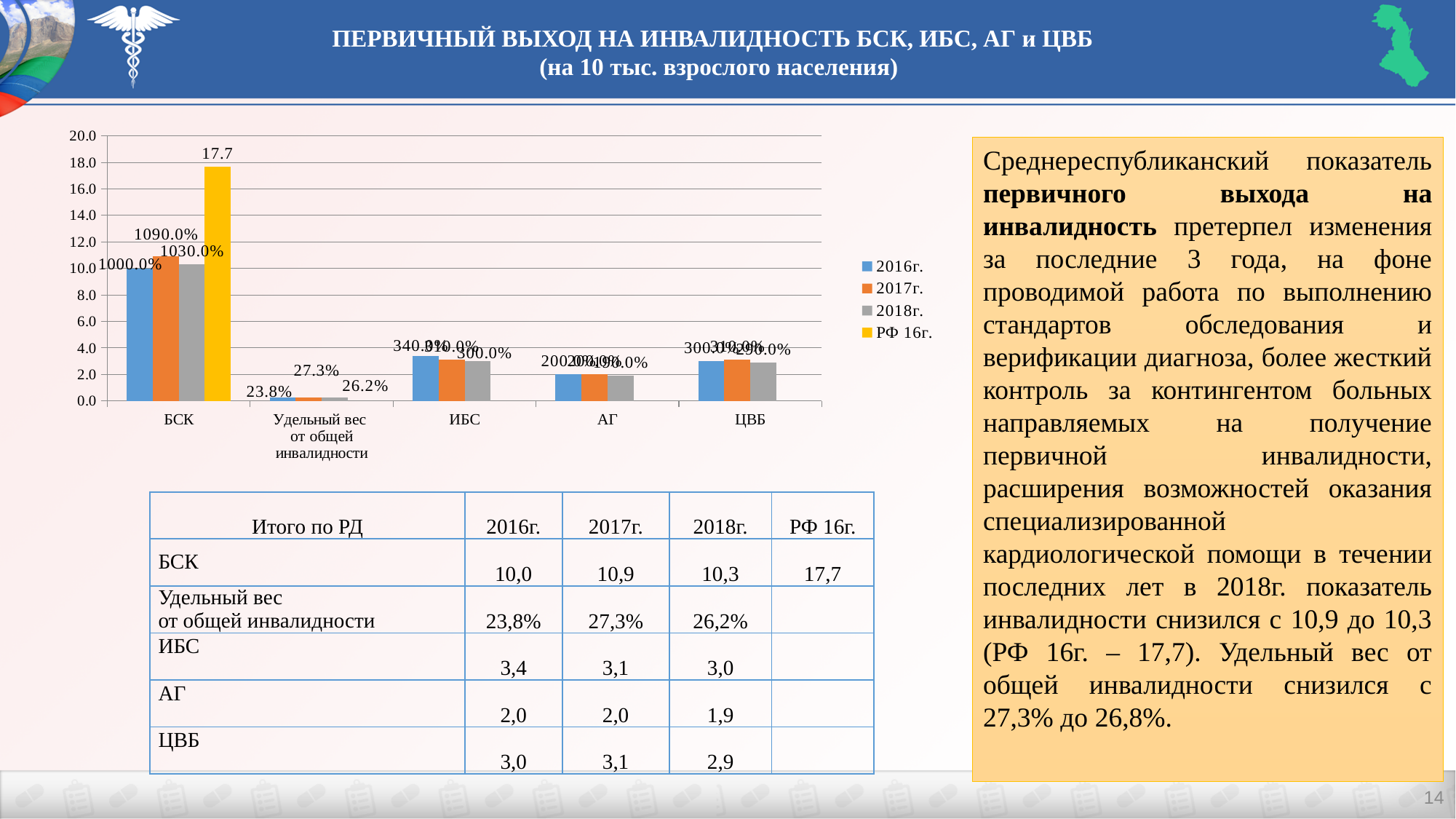
What colour are the РФ 16г. bars in the chart? Yellow What kind of chart is shown on the slide? Bar chart What is the 2016г. value for Удельный вес от общей инвалидности? 23.8% How many categories are shown along the x axis of the chart? 5 What is the difference between the 2017г. and 2018г. values for Удельный вес от общей инвалидности? 1.1% Is the 2016г. bar for БСК greater or less than 8.0? greater Which is larger for Удельный вес от общей инвалидности: the 2016г. value or the 2017г. value? 2017г. Is the 2016г. bar for ИБС greater or less than 4.0? less What is the 2017г. value for Удельный вес от общей инвалидности? 27.3% Which category has the tallest bar in the chart? БСК What is the value of the РФ 16г. bar for БСК? 17.7 How many series does the chart legend list? 4